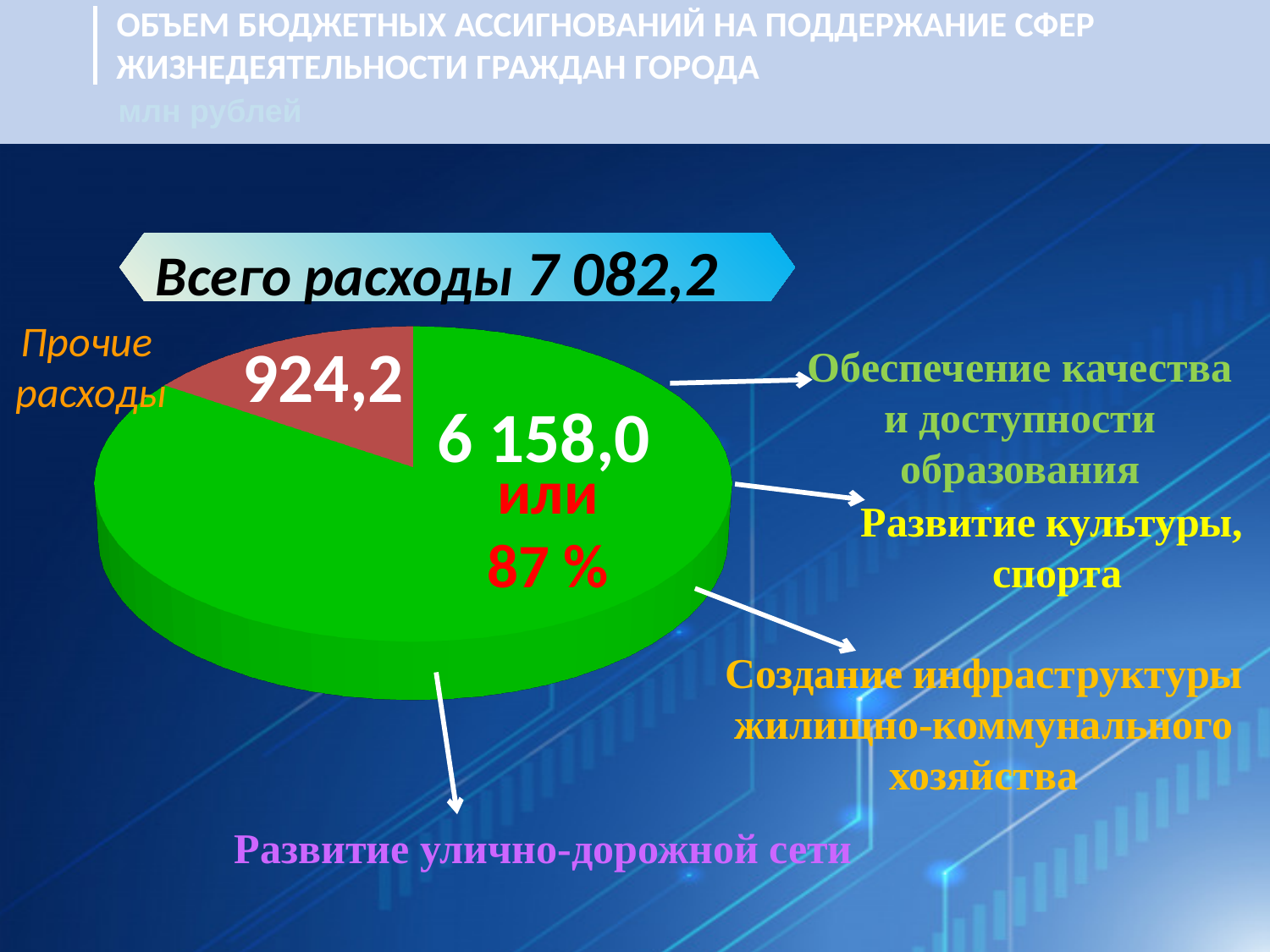
What is the value of the large green slice of the pie chart? 6 158,0 Which slice of the pie chart is the smallest? Прочие расходы (924,2) What percentage share of the pie does the green slice represent, as printed on the slide? 87 % What colour is the "Прочие расходы" slice of the pie chart? red What kind of chart is shown on the slide? pie chart What is the total of all expenses ("Всего расходы") shown on the slide? 7 082,2 Which slice of the pie chart is the largest? the green slice (6 158,0) How many slices does the pie chart have? 2 What is the difference between the green slice (6 158,0) and the "Прочие расходы" slice (924,2)? 5 233,8 Which is larger: the green slice or the "Прочие расходы" slice? the green slice In what units are the values on the slide expressed, according to the subtitle? млн рублей What is the value of the slice labelled "Прочие расходы"? 924,2